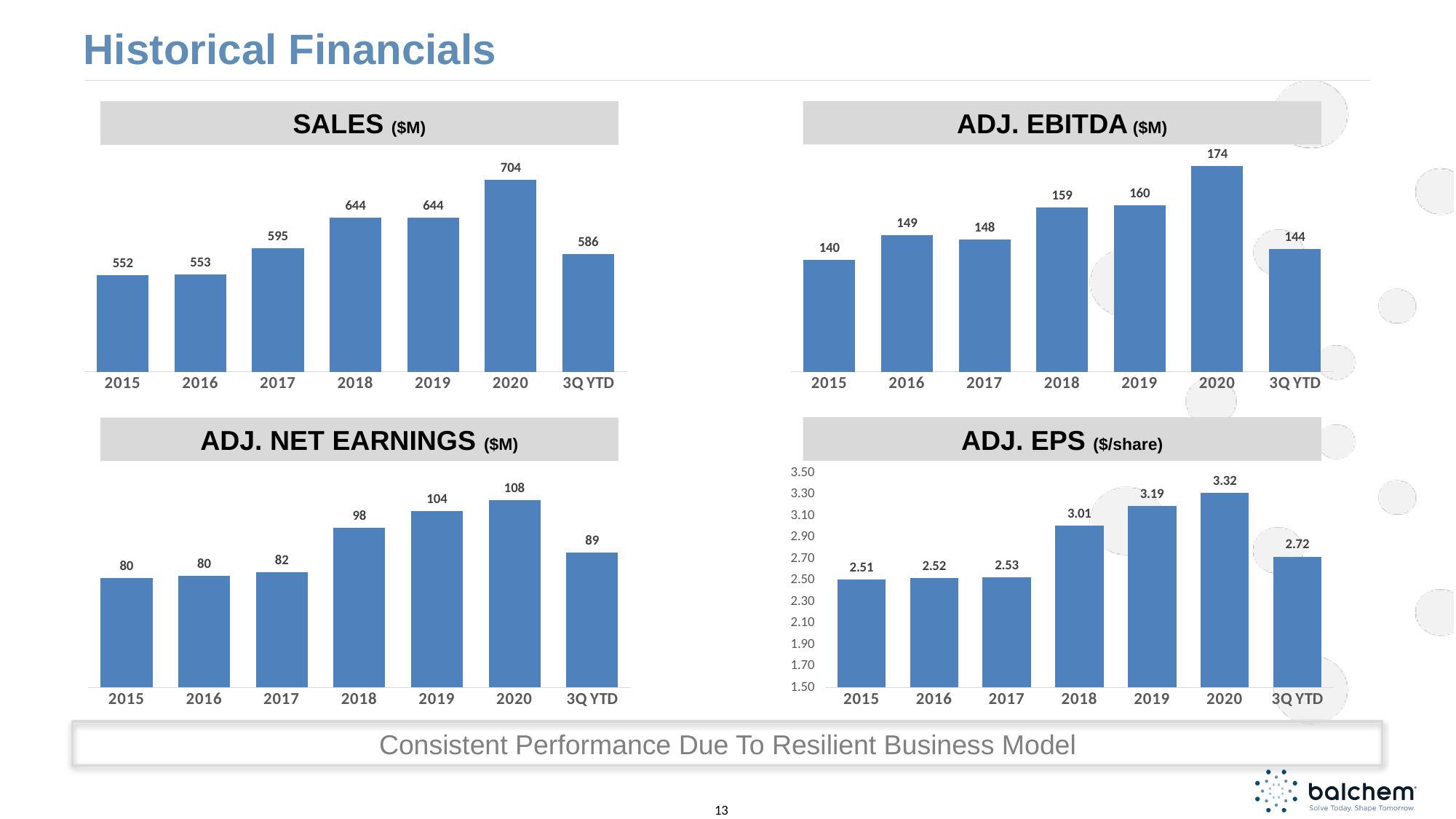
In the ADJ. EBITDA ($M) chart, how many bars are plotted? 7 What kind of chart is the ADJ. EPS ($/share) chart? bar chart In the ADJ. EBITDA ($M) chart, what is the value for 2018? 159 In the ADJ. EPS ($/share) chart, what is the value for 2019? 3.19 In the ADJ. NET EARNINGS ($M) chart, which is larger, the value for 2019 or the value for 2018? 2019 In the SALES ($M) chart, which year has the lowest value? 2015 In the ADJ. NET EARNINGS ($M) chart, what is the difference between the 2020 value and the 2015 value? 28 In the ADJ. EBITDA ($M) chart, which category has the highest value? 2020 In the SALES ($M) chart, what is the value for 2020? 704 In the ADJ. EPS ($/share) chart, do the values rise or fall from 2015 to 2020? rise In the SALES ($M) chart, what is the difference between the 2020 value and the 2017 value? 109 In the ADJ. NET EARNINGS ($M) chart, what is the value for 3Q YTD? 89